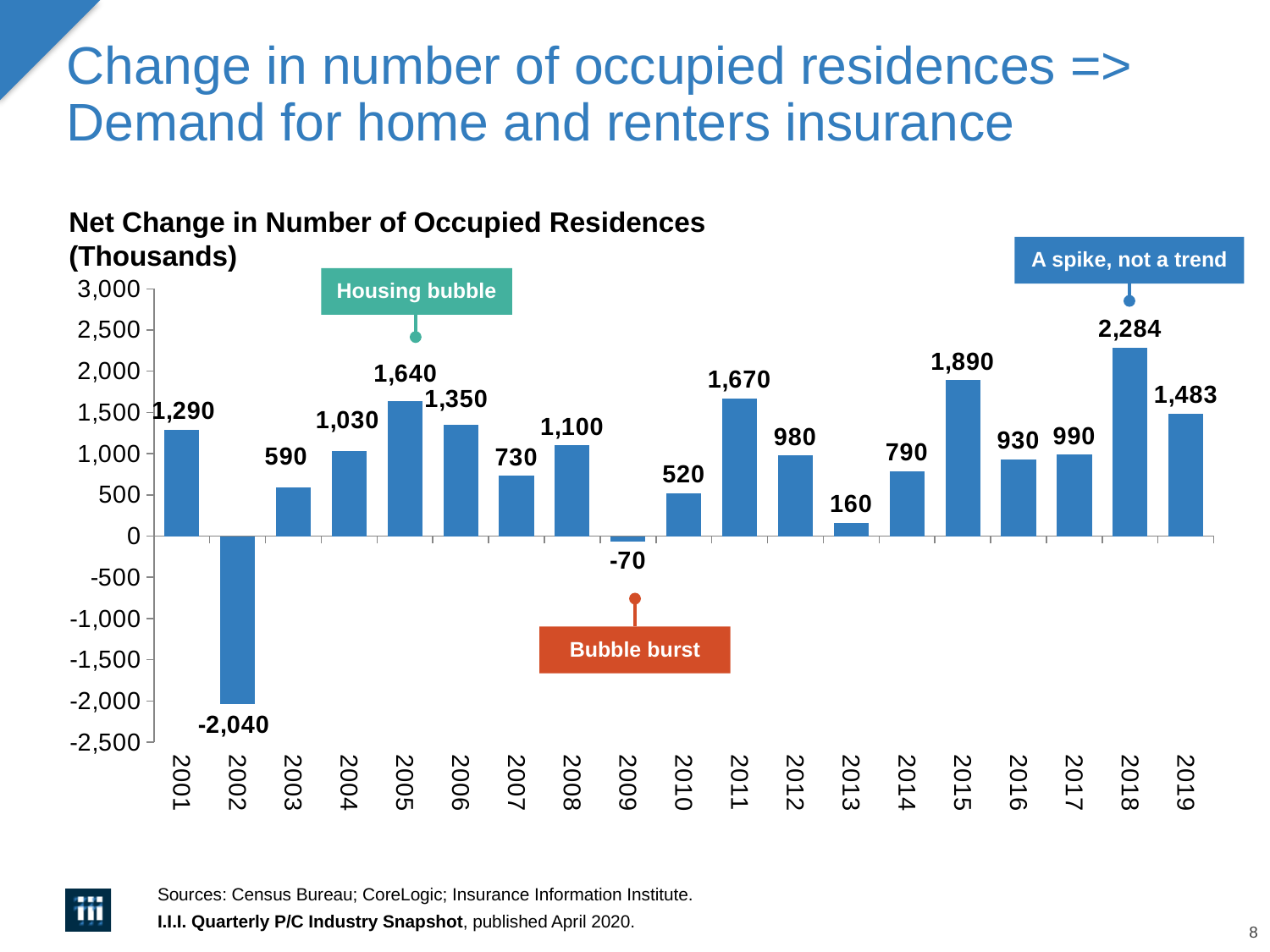
Is the value for 2013 greater or less than 500? less What does the callout label pointing to the 2009 bar say? Bubble burst Which year has the highest net change in occupied residences? 2018 What is the value shown for 2002? -2,040 What kind of chart is shown on the slide? Bar chart Which year has the larger value, 2011 or 2015? 2015 What is the net change in number of occupied residences for 2018? 2,284 What is the value shown for 2009? -70 Which year has the lowest net change in occupied residences? 2002 What is the difference between the values for 2018 and 2019? 801 What is the title of the chart? Net Change in Number of Occupied Residences (Thousands) How many years are shown on the x axis? 19